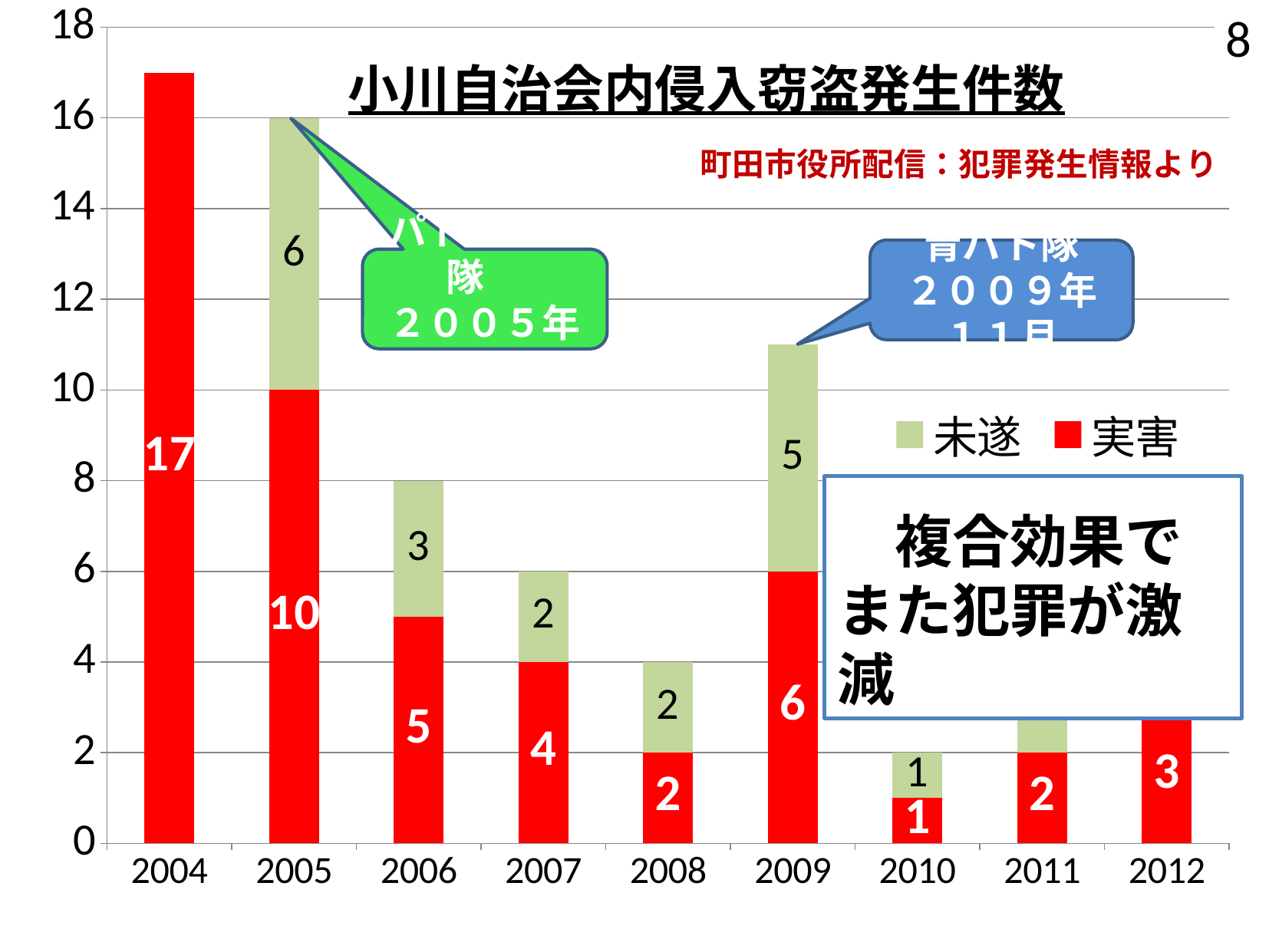
How many series does the legend list? 2 What type of chart is shown on the slide? stacked bar chart Which year has the lowest 実害 value? 2010 Which year has the highest 実害 value? 2004 What is the title of the chart? 小川自治会内侵入窃盗発生件数 Which is larger, the 実害 value for 2009 or the 実害 value for 2006? 2009 How many years are shown on the x axis? 9 What is the 未遂 value for 2009? 5 What is the 実害 value for 2004? 17 What is the 実害 value for 2010? 1 What is the difference between the 実害 values for 2004 and 2005? 7 What is the total of the stacked bar for 2005? 16